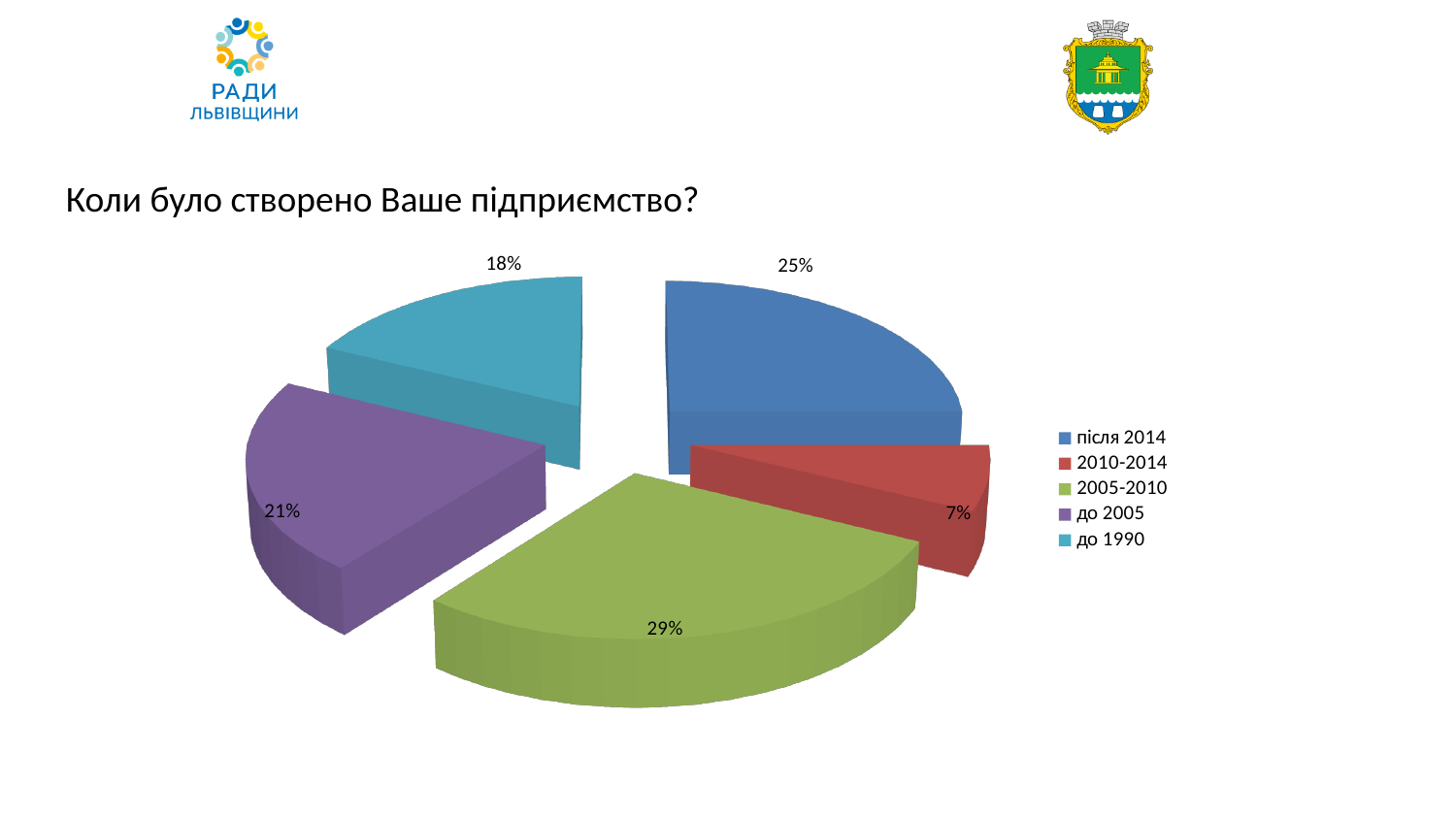
What share of the pie does the "2005-2010" slice represent? 29% Which category has the smallest slice of the pie? 2010-2014 What is the value shown for "до 1990"? 18% What is the difference in percentage points between "2005-2010" and "2010-2014"? 22 What is the value shown for "до 2005"? 21% Which is larger, the slice for "після 2014" or the slice for "до 2005"? після 2014 What is the value shown for "після 2014"? 25% Which category has the largest slice of the pie? 2005-2010 What is the value shown for "2010-2014"? 7% What kind of chart is shown on the slide? pie chart How many categories does the pie chart show? 5 What is the title of the chart on the slide? Коли було створено Ваше підприємство?